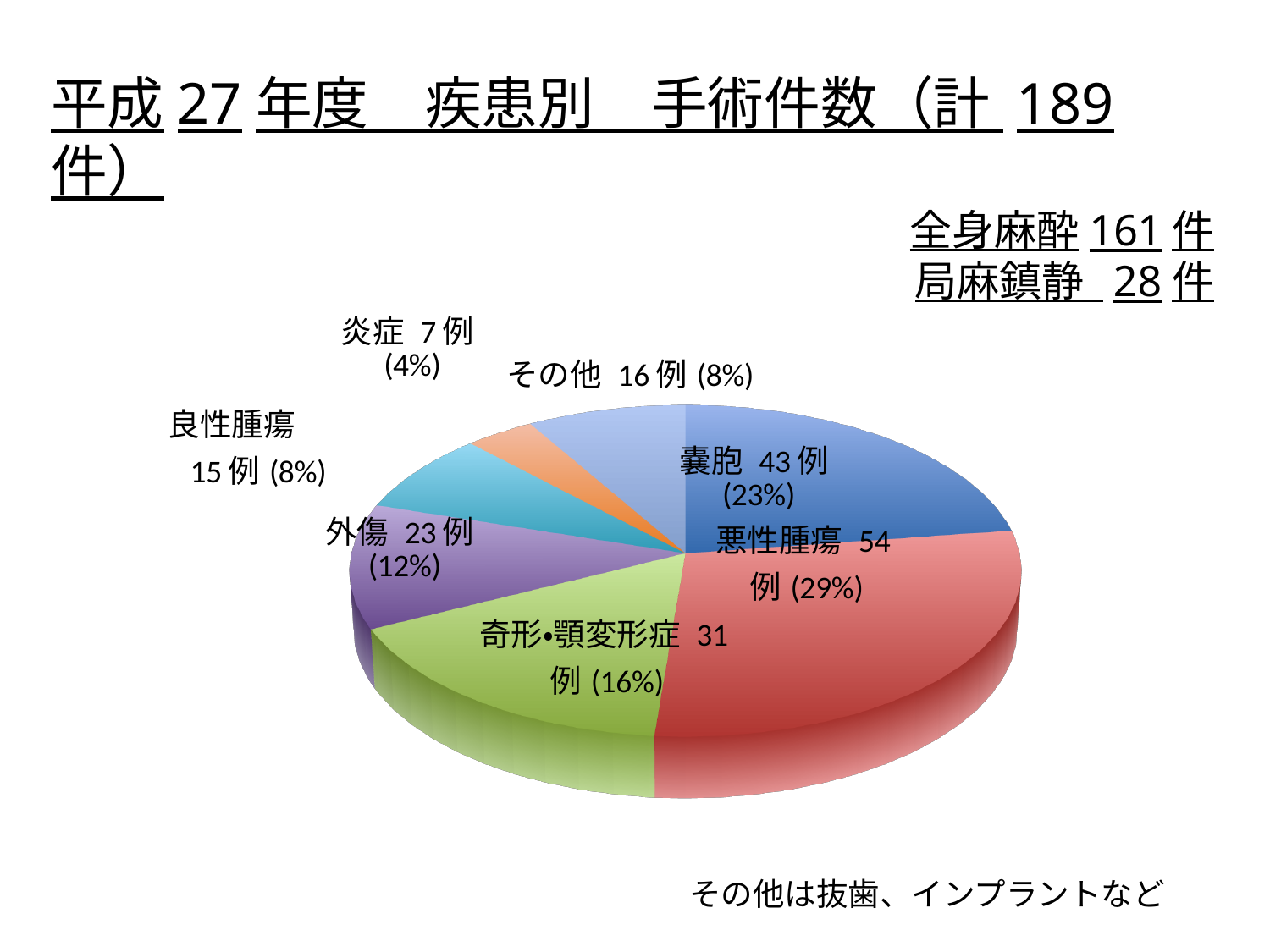
How many cases are shown for その他? 16 例 What percentage share does 良性腫瘍 have in the pie chart? 8% How many categories (slices) does the pie chart have? 7 What is the difference in cases between 悪性腫瘍 and 嚢胞? 11 例 What percentage share does 嚢胞 have in the pie chart? 23% How many cases are shown for 外傷? 23 例 Which has more cases, 奇形•顎変形症 or 外傷? 奇形•顎変形症 What is the total number of cases given in the chart title? 189 件 What kind of chart is shown on the slide? pie chart Which category has the smallest slice of the pie chart? 炎症 Which category has the largest slice of the pie chart? 悪性腫瘍 How many cases are shown for 悪性腫瘍? 54 例